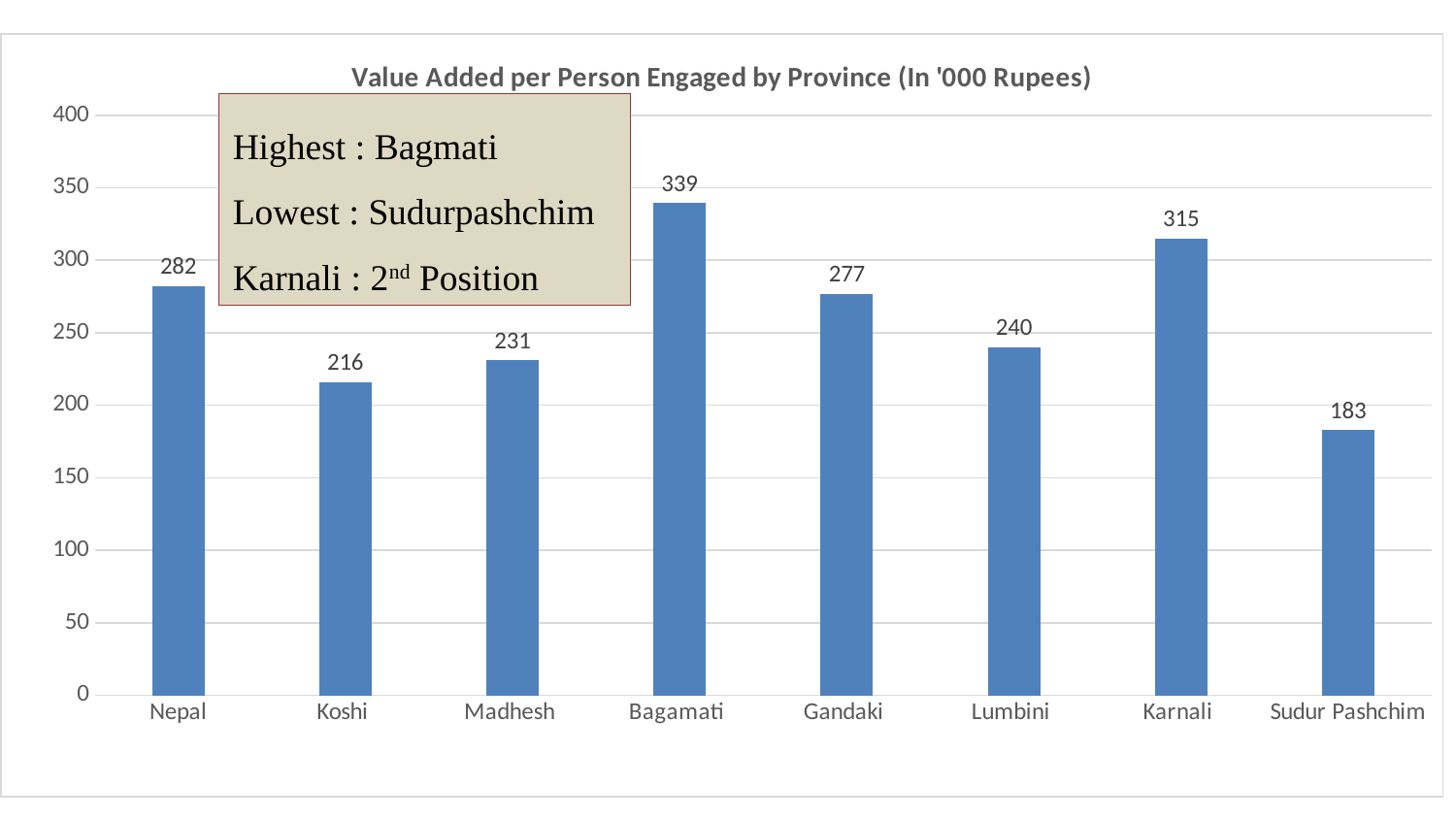
What is the value added per person engaged for Lumbini? 240 Which province has the lowest value added per person engaged? Sudur Pashchim What is the difference between the values for Karnali and Koshi? 99 What is the difference between the values for Bagamati and Sudur Pashchim? 156 Which province has the highest value added per person engaged? Bagamati What is the title of the chart? Value Added per Person Engaged by Province (In '000 Rupees) Which has a larger value, Madhesh or Lumbini? Lumbini How many categories are shown on the x axis? 8 What is the value added per person engaged for Gandaki? 277 What kind of chart is shown on the slide? Bar chart Is the value for Karnali greater or less than 300? greater What is the value added per person engaged for Nepal? 282